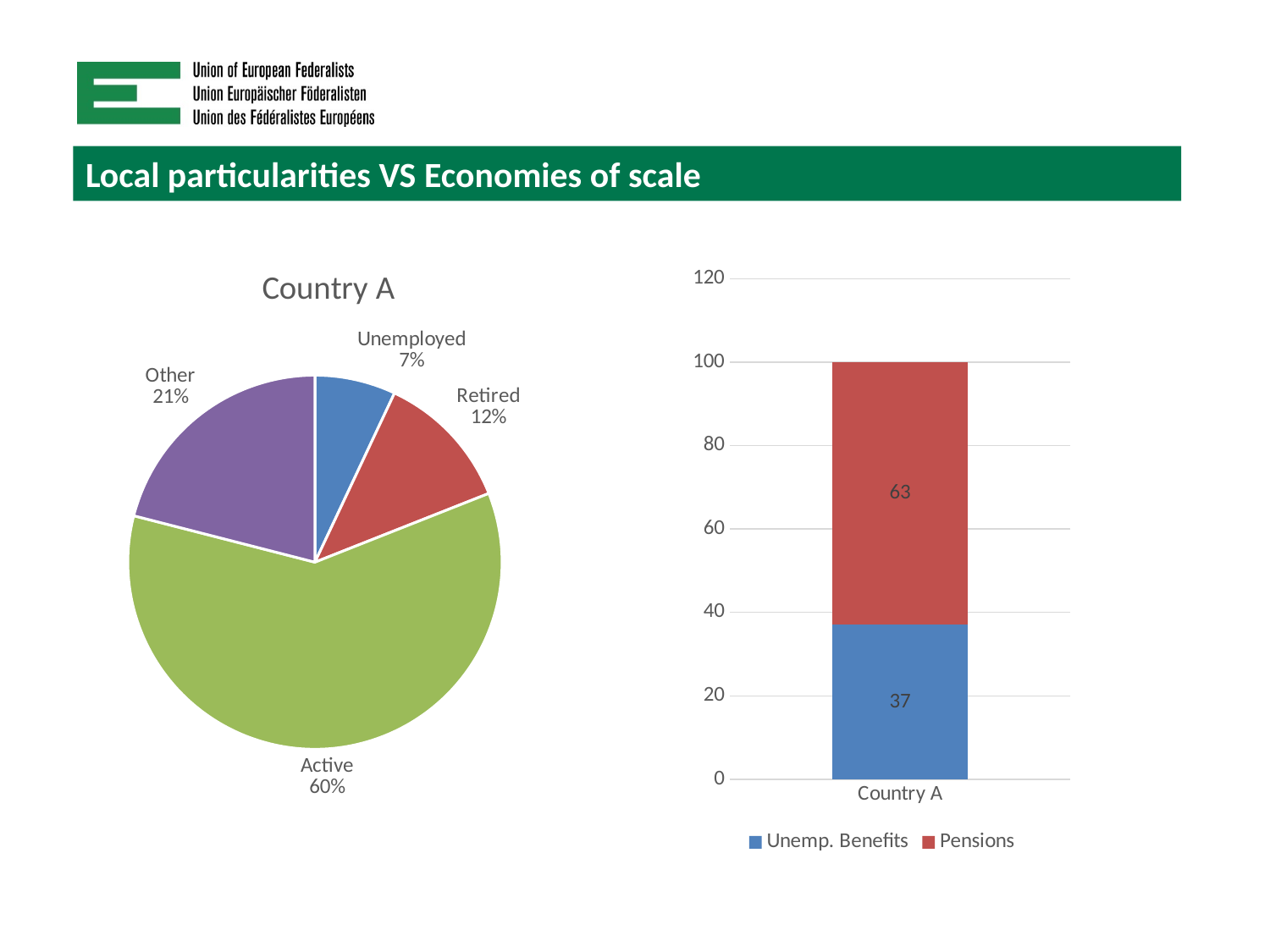
In the stacked bar chart on the right, what is the total of the Country A bar? 100 In the stacked bar chart on the right, what is the value for Unemp. Benefits for Country A? 37 What kind of chart is on the left of the slide? Pie chart In the pie chart titled Country A, which is larger, Other or Retired? Other In the pie chart titled Country A, what share does Unemployed have? 7% In the stacked bar chart on the right, what is the value for Pensions for Country A? 63 In the pie chart titled Country A, which category has the largest share? Active In the stacked bar chart on the right, how many series does the legend list? 2 In the pie chart titled Country A, which category has the smallest share? Unemployed In the pie chart titled Country A, what is the difference in percentage points between Other and Retired? 9 In the pie chart titled Country A, what share does Active have? 60% In the pie chart titled Country A, how many slices are there? 4